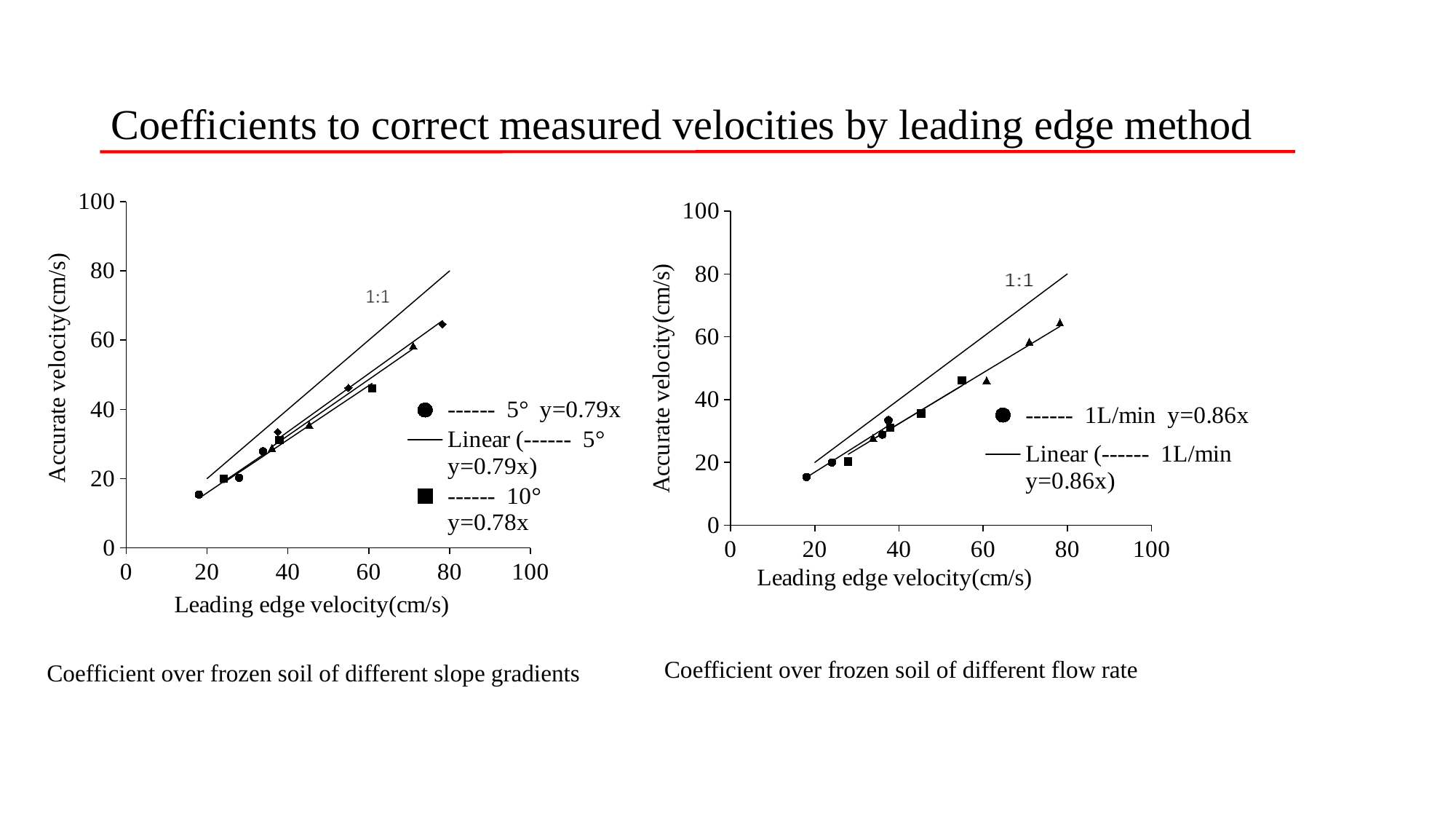
In the left chart (different slope gradients), is the accurate velocity of the highest point (at a leading edge velocity of about 78 cm/s) greater or less than 60? greater In the left chart (different slope gradients), is the accurate velocity of the lowest point (at a leading edge velocity of about 18 cm/s) greater or less than 20? less In the right chart (different flow rate), what is the label of the x axis? Leading edge velocity(cm/s) In the left chart (different slope gradients), what equation is given for the 5° series? y=0.79x What kind of chart is the left chart, 'Coefficient over frozen soil of different slope gradients'? Scatter chart In the right chart (different flow rate), what equation is given for the 1L/min series? y=0.86x In the right chart (different flow rate), does accurate velocity rise or fall as leading edge velocity increases? rise In the left chart (different slope gradients), does accurate velocity rise or fall as leading edge velocity increases? rise In the right chart (different flow rate), is the accurate velocity of the lowest point (at a leading edge velocity of about 18 cm/s) greater or less than 20? less In the left chart (different slope gradients), what is the label of the y axis? Accurate velocity(cm/s) In the left chart (different slope gradients), what equation is given for the 10° series? y=0.78x